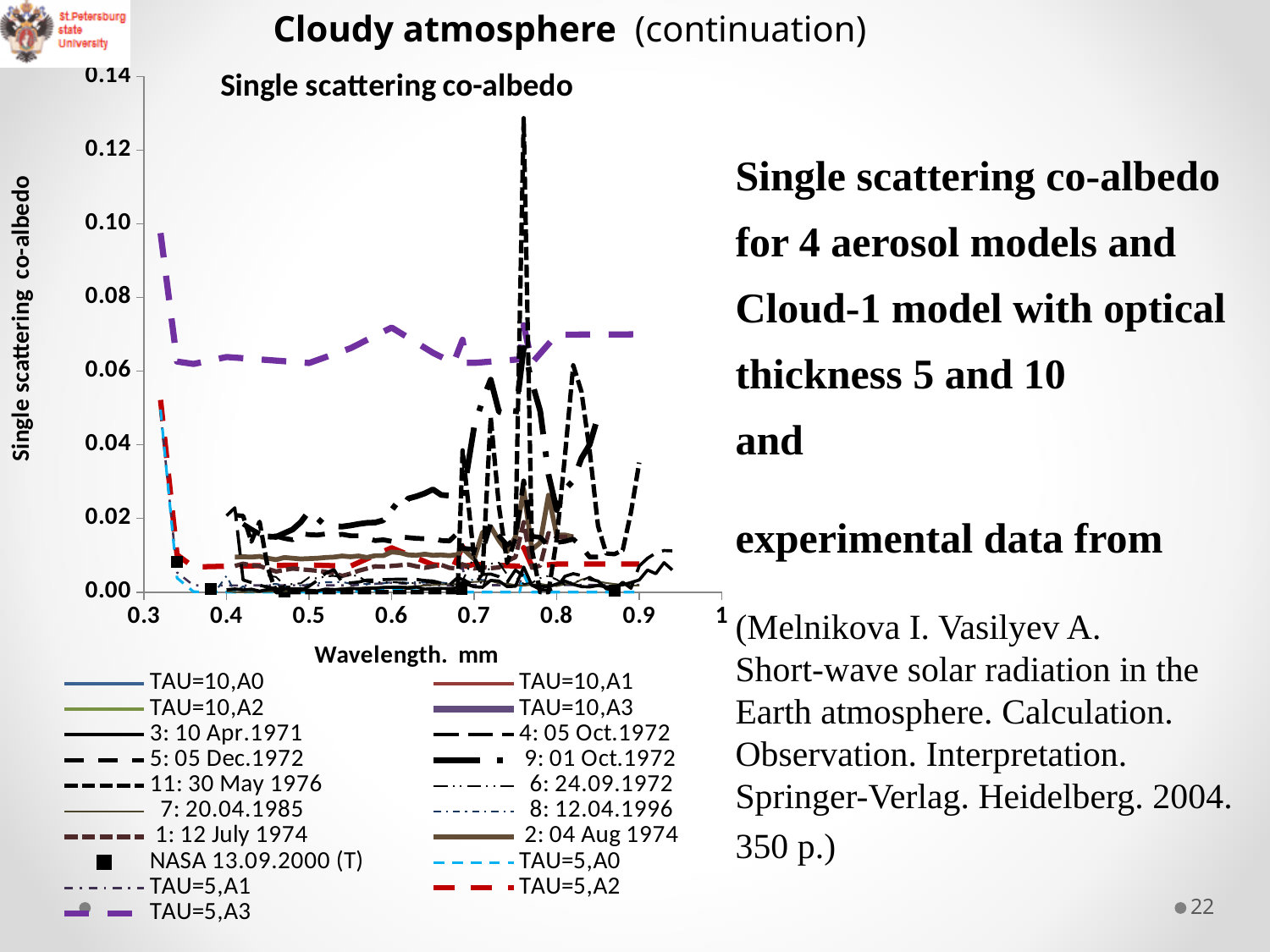
Is the value of the TAU=5,A0 series at wavelength 0.6 greater or less than 0.02? less Is the value of the TAU=5,A3 series at wavelength 0.6 greater or less than 0.04? greater What is the label of the x axis of the chart? Wavelength. mm Is the value of the TAU=5,A2 series at wavelength 0.5 greater or less than 0.02? less Does the TAU=5,A3 series rise or fall between wavelength 0.3 and 0.4? fall What is the maximum value shown on the y axis of the chart? 0.14 How many series does the chart legend list? 19 What is the title of the chart? Single scattering co-albedo At wavelength 0.6, which series has the larger value, TAU=5,A3 or TAU=5,A2? TAU=5,A3 What kind of chart is shown on the slide? line chart